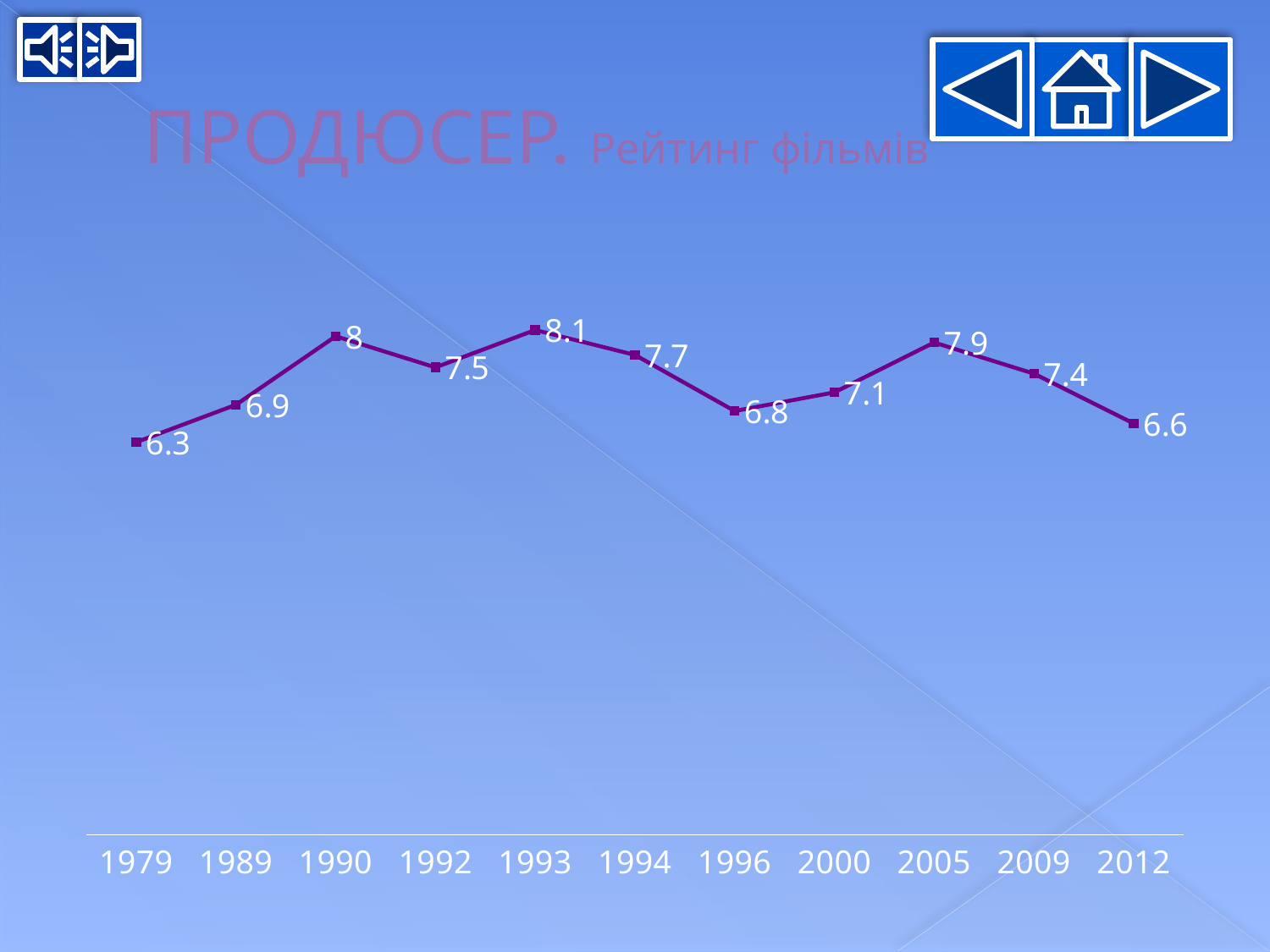
What is the rating value for 2012? 6.6 What is the difference between the rating for 1993 and the rating for 1979? 1.8 Which year has the highest rating? 1993 Which has a higher rating, 1990 or 1996? 1990 What is the rating value for 2005? 7.9 How many years are plotted on the chart? 11 What is the rating value for 1979? 6.3 Which year has the lowest rating? 1979 What kind of chart is shown on the slide? line chart What is the title of the slide containing the chart? ПРОДЮСЕР. Рейтинг фільмів Do the ratings rise or fall from 2005 to 2012? fall What is the rating value for 1993? 8.1